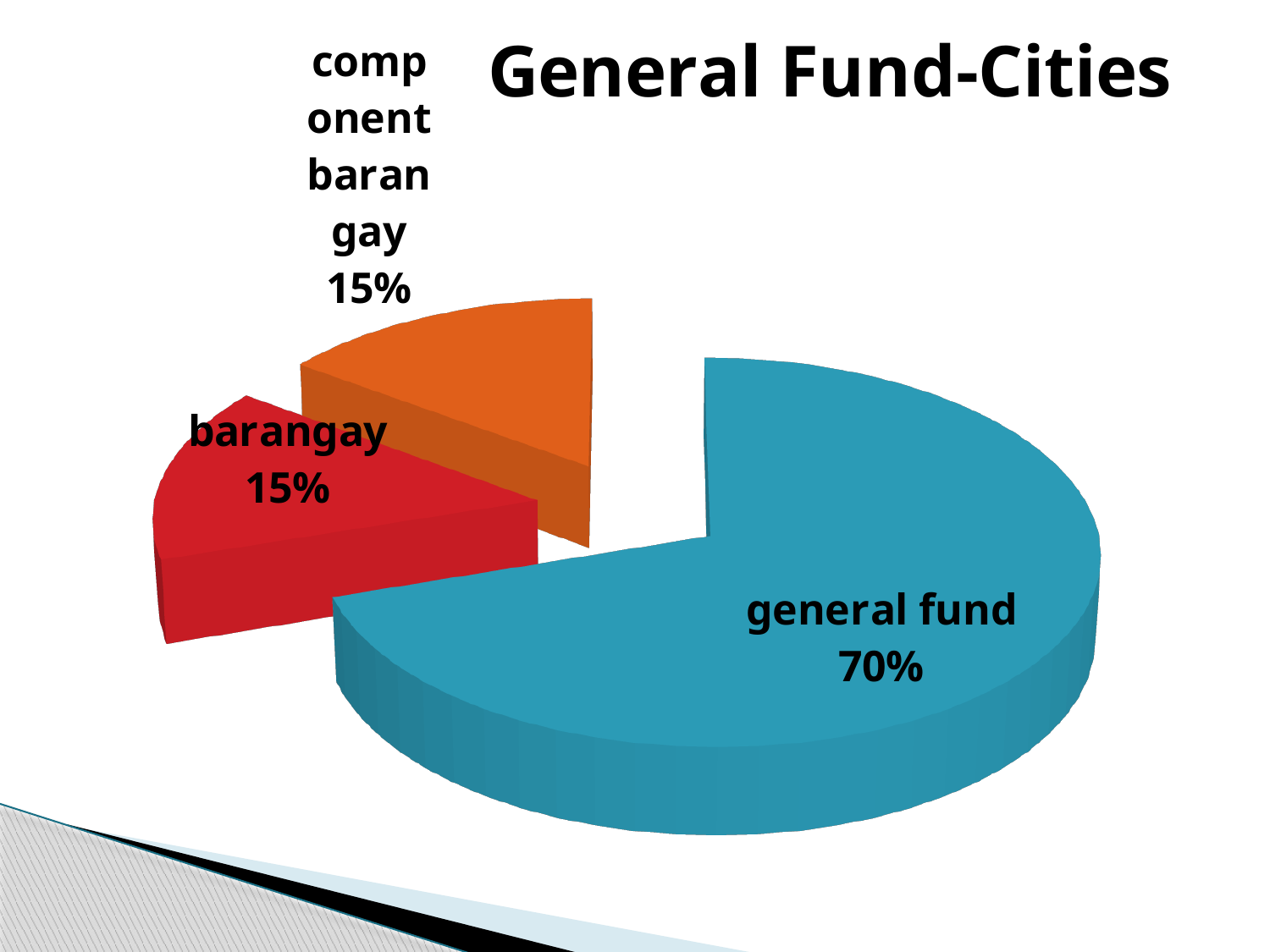
How many slices does the pie chart have? 3 Which is larger, general fund or component barangay? general fund What colour is the general fund slice? blue What is the combined share of barangay and component barangay? 30% Which slice is the largest? general fund What kind of chart is shown on the slide? pie chart What is the difference in percentage points between general fund and barangay? 55 What share of the pie does general fund represent? 70% What share of the pie does component barangay represent? 15% What share of the pie does barangay represent? 15% What is the title of the chart? General Fund-Cities